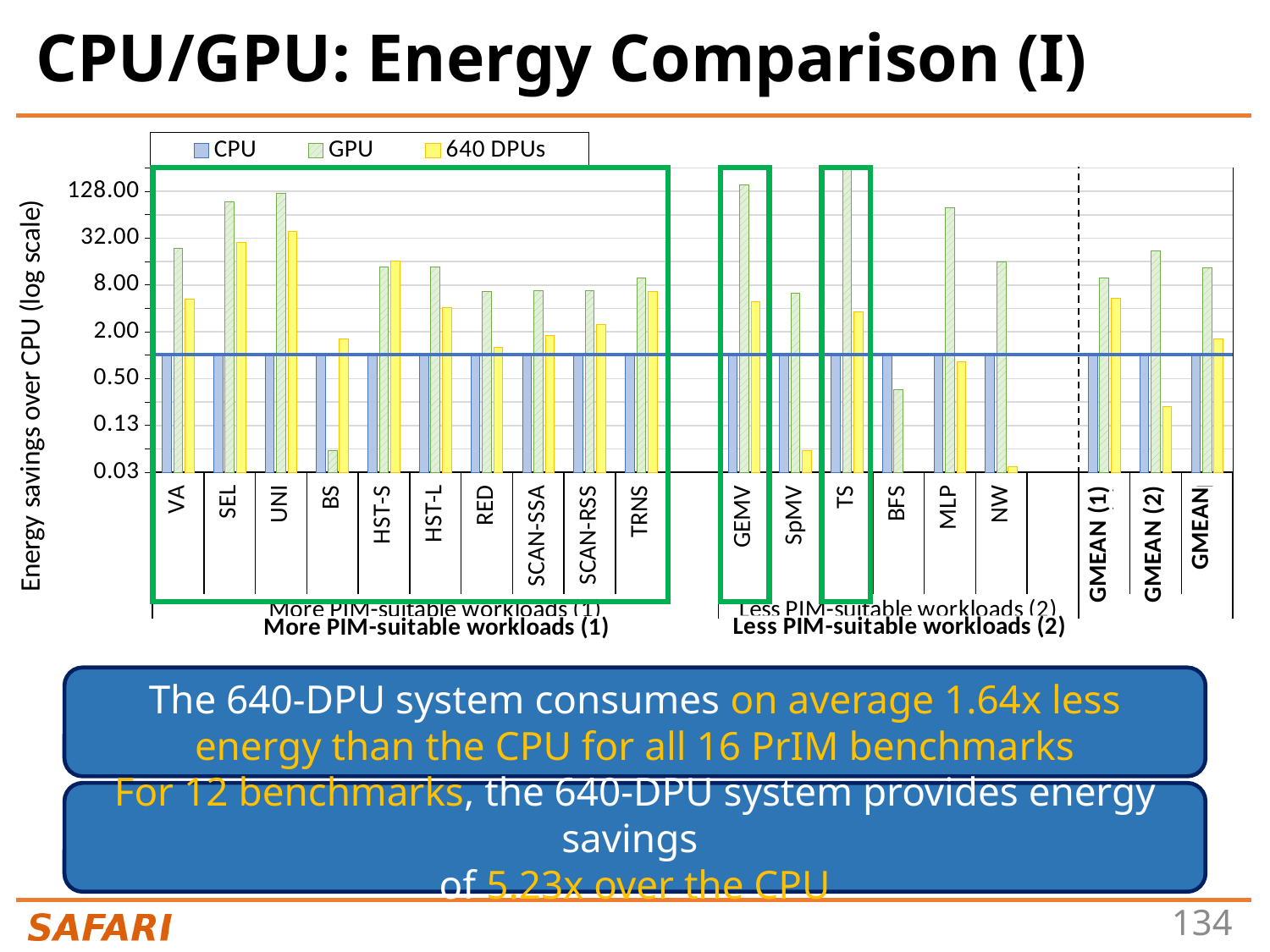
What is the label of the y axis? Energy savings over CPU (log scale) What kind of chart is shown on the slide? bar chart Which category has the highest GPU value? TS Is the GPU value for BFS greater or less than 0.50? less Which category has the lowest GPU value? BS For BS, which is larger: the GPU value or the 640 DPUs value? 640 DPUs How many series does the legend list? 3 Is the 640 DPUs value for BS greater or less than 2.00? less Is the 640 DPUs value for VA greater or less than 2.00? greater How many categories are shown along the x axis? 19